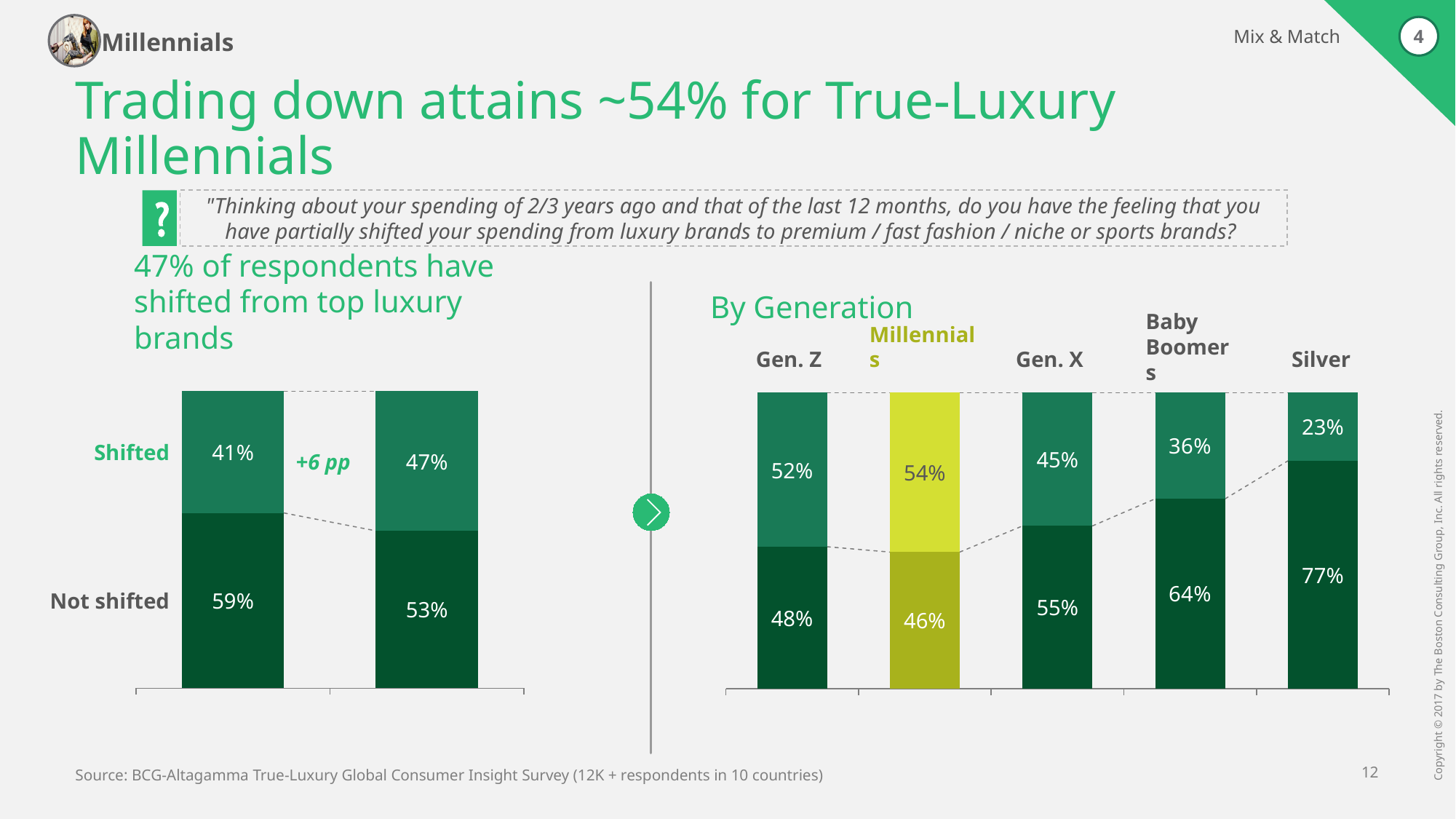
In the left chart, what change in the 'Shifted' share is annotated between the two bars? +6 pp In the 'By Generation' chart, what is the 'Shifted' value for Millennials? 54% In the 'By Generation' chart, does the 'Shifted' share rise or fall from Millennials to Silver? Fall In the 'By Generation' chart, which generation has the highest 'Shifted' share? Millennials In the 'By Generation' chart, what is the 'Shifted' value for Baby Boomers? 36% In the 'By Generation' chart, which is larger: the 'Not shifted' value for Gen. X or for Baby Boomers? Baby Boomers What kind of chart is the 'By Generation' chart? Stacked bar chart In the 'By Generation' chart, what is the 'Not shifted' value for Silver? 77% In the left chart, what is the 'Shifted' value for the right-hand bar? 47% In the 'By Generation' chart, which generation has the lowest 'Shifted' share? Silver How many generations are shown in the 'By Generation' chart? 5 In the 'By Generation' chart, what is the difference between the 'Shifted' values for Gen. Z and Gen. X? 7 percentage points